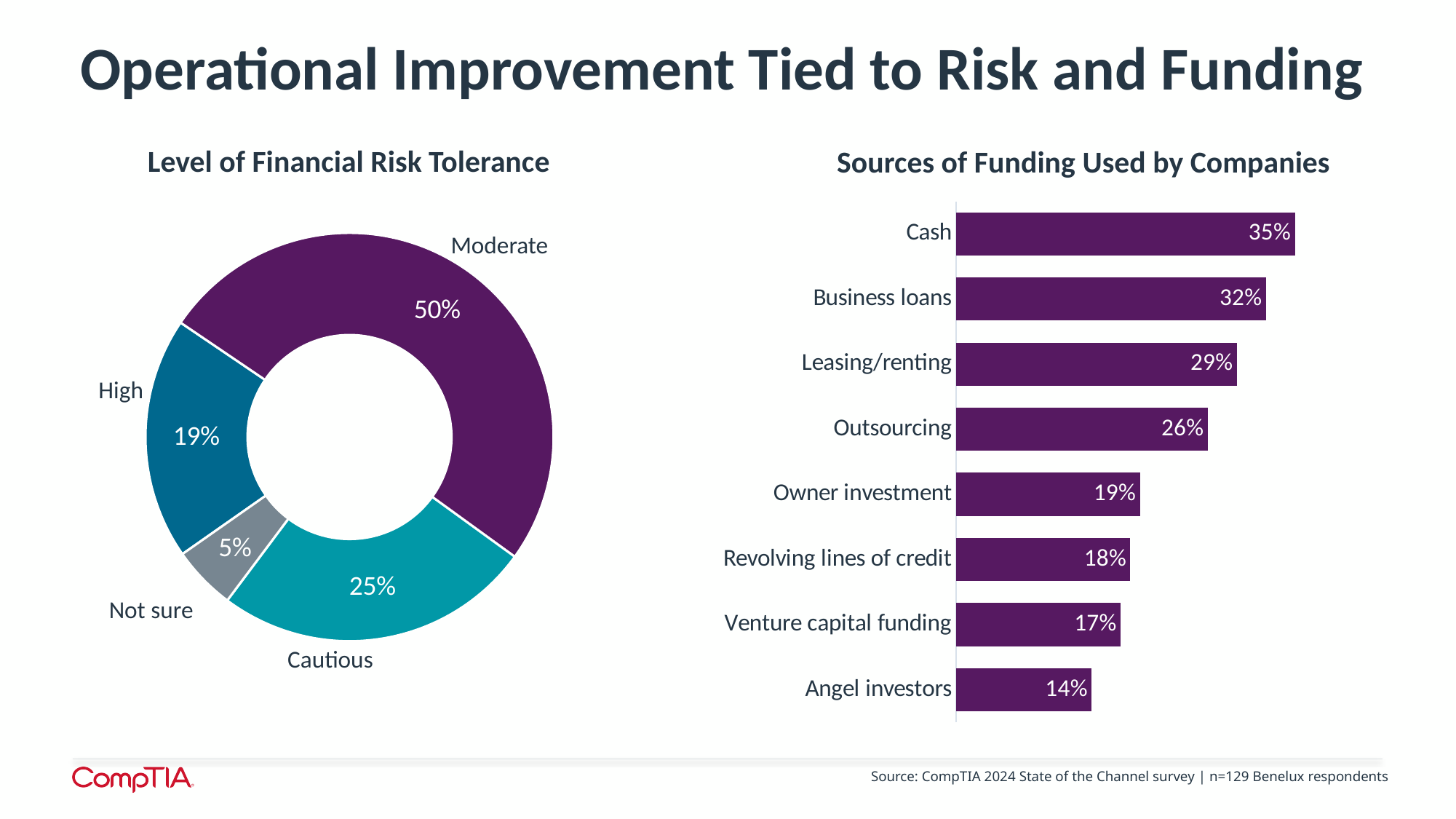
In the 'Sources of Funding Used by Companies' chart, what is the difference between Cash and Business loans? 3% In the 'Level of Financial Risk Tolerance' chart, what is the difference between the Cautious and High shares? 6% What kind of chart is 'Level of Financial Risk Tolerance'? Doughnut chart In the 'Sources of Funding Used by Companies' chart, what is the value for Leasing/renting? 29% In the 'Sources of Funding Used by Companies' chart, what is the value for Revolving lines of credit? 18% In the 'Sources of Funding Used by Companies' chart, which funding source has the lowest value? Angel investors In the 'Level of Financial Risk Tolerance' chart, what share of respondents reported a Moderate risk tolerance? 50% In the 'Level of Financial Risk Tolerance' chart, which category has the largest share? Moderate In the 'Sources of Funding Used by Companies' chart, how many funding sources are listed? 8 In the 'Sources of Funding Used by Companies' chart, which funding source has the highest value? Cash In the 'Level of Financial Risk Tolerance' chart, what percentage is shown for Not sure? 5% What kind of chart is 'Sources of Funding Used by Companies'? Bar chart